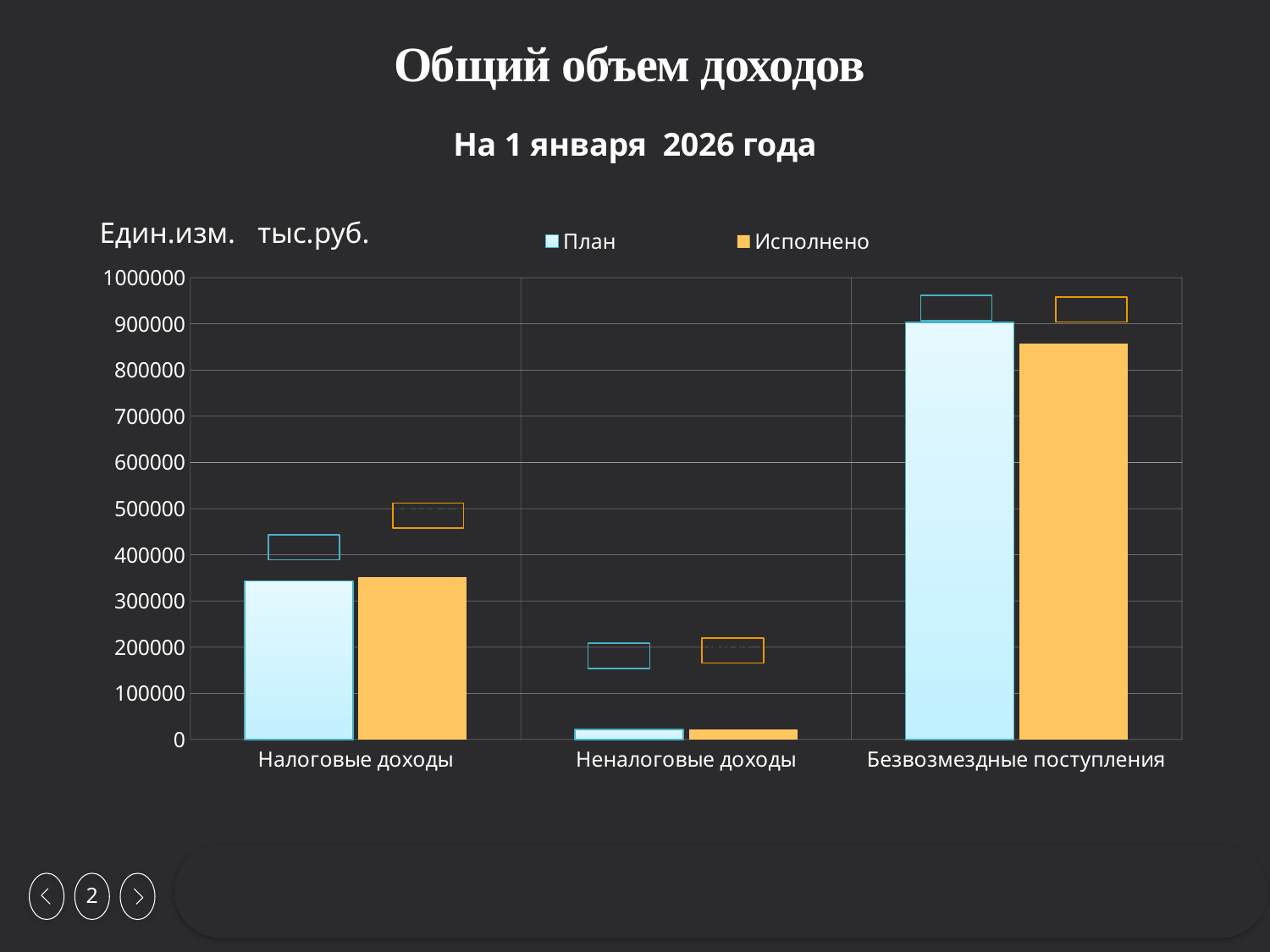
Which category has the highest value for План? Безвозмездные поступления What unit of measurement is stated for the chart? тыс.руб. How many categories are shown on the x axis? 3 Is the value for Исполнено in Безвозмездные поступления greater or less than 800000? greater Is the value for План in Неналоговые доходы greater or less than 100000? less What kind of chart is shown on the slide? bar chart For Безвозмездные поступления, which is larger: План or Исполнено? План Is the value for Исполнено in Налоговые доходы greater or less than 400000? less How many series does the legend list? 2 What is the title of the chart? Общий объем доходов Which category has the lowest value for Исполнено? Неналоговые доходы